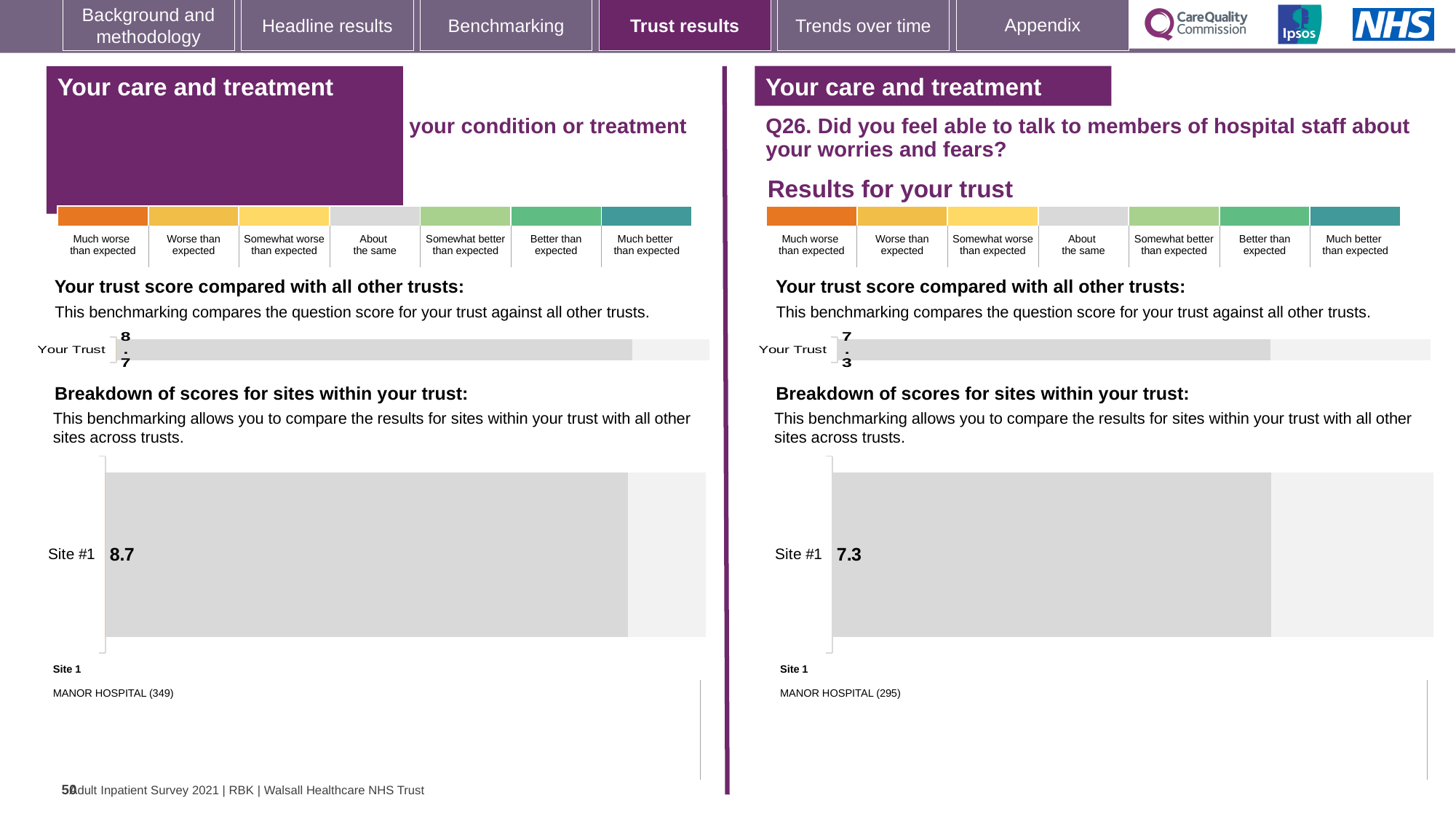
What type of chart is used to show the Site #1 score on the right-hand side of the slide? Bar chart In the right-hand (Q26) 'Breakdown of scores for sites within your trust' chart, what is the score for Site #1? 7.3 How many sites are shown in the right-hand (Q26) 'Breakdown of scores for sites within your trust' chart? 1 Which hospital is listed as Site 1 on the right-hand side of the slide, and how many respondents are shown in brackets? MANOR HOSPITAL (295) What is the difference between the Site #1 score on the left-hand side of the slide and the Site #1 score for Q26 on the right-hand side? 1.4 In the left-hand 'Breakdown of scores for sites within your trust' chart, what is the score for Site #1? 8.7 On the right-hand side of the slide (Q26), what is the score shown for Your Trust in the 'Your trust score compared with all other trusts' chart? 7.3 Which hospital is listed as Site 1 on the left-hand side of the slide, and how many respondents are shown in brackets? MANOR HOSPITAL (349) On the left-hand side of the slide, what is the score shown for Your Trust in the 'Your trust score compared with all other trusts' chart? 8.7 Is the Site #1 score in the right-hand (Q26) breakdown chart greater or less than 8? less How many sites are shown in the left-hand 'Breakdown of scores for sites within your trust' chart? 1 Which is larger: the Your Trust score on the left-hand side of the slide or the Your Trust score for Q26 on the right-hand side? The left-hand side (8.7)